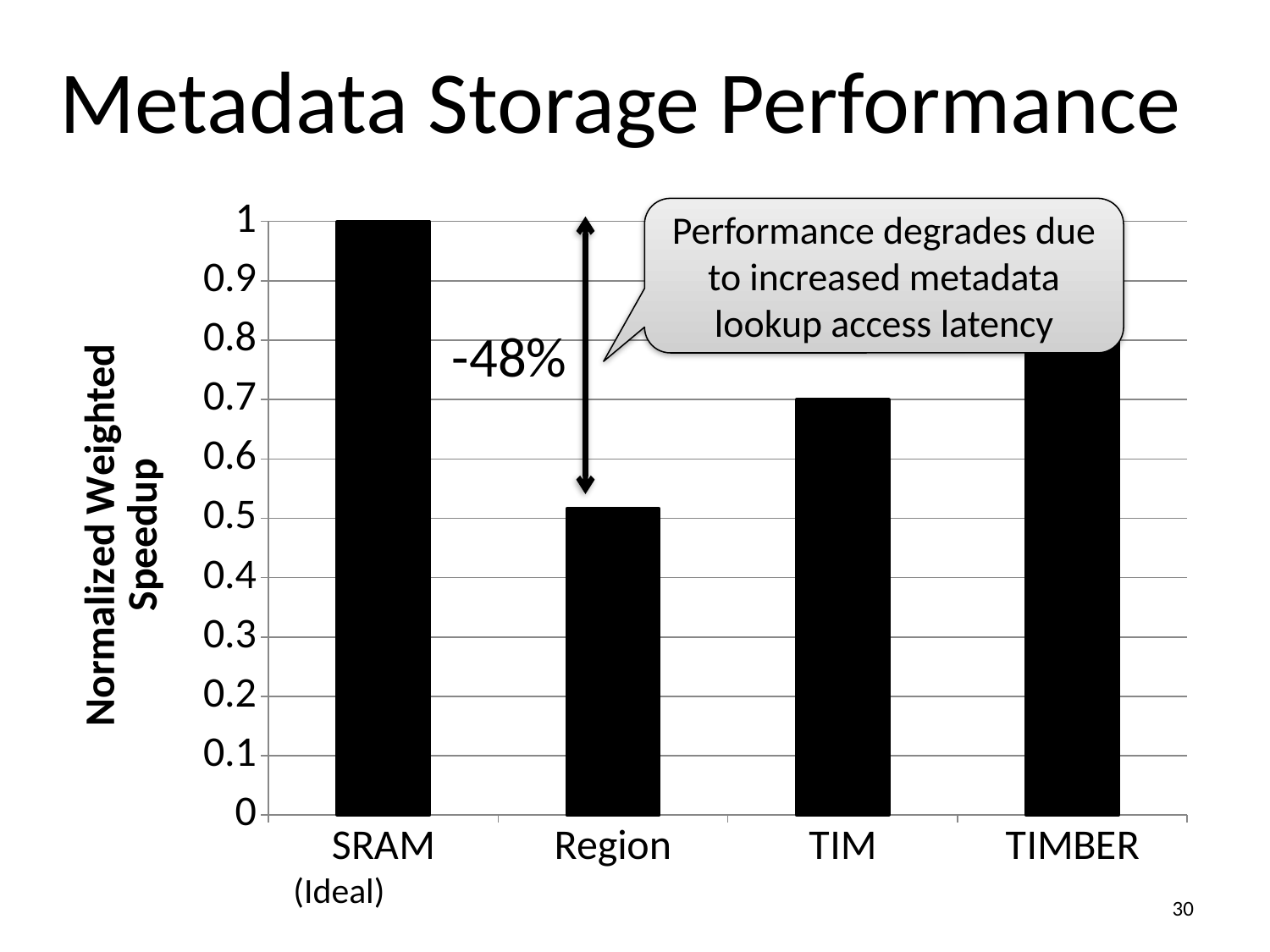
What percentage change is annotated between the SRAM (Ideal) bar and the Region bar? -48% What is the label of the y axis? Normalized Weighted Speedup Is the value for Region greater or less than 0.6? less Is the value for TIMBER greater or less than 0.7? greater What kind of chart is shown on the slide? bar chart Which category has the highest normalized weighted speedup? SRAM (Ideal) How many categories are plotted on the x axis? 4 Which category has the lowest normalized weighted speedup? Region What is the normalized weighted speedup for TIM? 0.7 Which has a larger normalized weighted speedup, TIM or Region? TIM What is the normalized weighted speedup for SRAM (Ideal)? 1